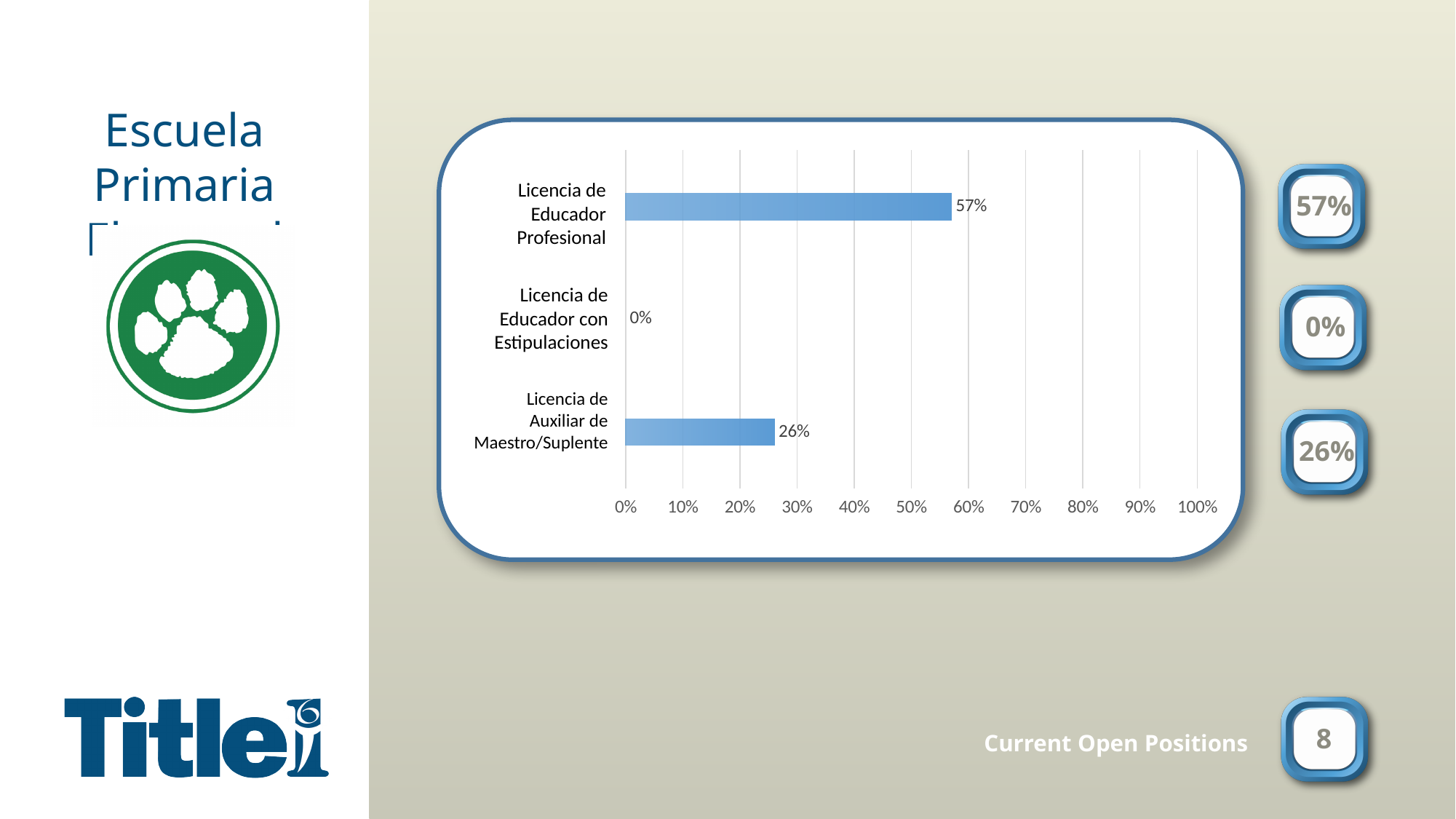
What kind of chart is shown on the slide? bar chart Is the value for Licencia de Educador Profesional greater or less than 50%? greater What is the maximum value shown on the horizontal axis of the chart? 100% What is the difference between the values for Licencia de Educador Profesional and Licencia de Auxiliar de Maestro/Suplente? 31% Which is larger, the value for Licencia de Educador Profesional or the value for Licencia de Auxiliar de Maestro/Suplente? Licencia de Educador Profesional Is the value for Licencia de Auxiliar de Maestro/Suplente greater or less than 30%? less What is the value for Licencia de Educador Profesional? 57% What is the value for Licencia de Auxiliar de Maestro/Suplente? 26% Which category has the highest value? Licencia de Educador Profesional What is the value for Licencia de Educador con Estipulaciones? 0% How many categories are shown in the chart? 3 Which category has the lowest value? Licencia de Educador con Estipulaciones